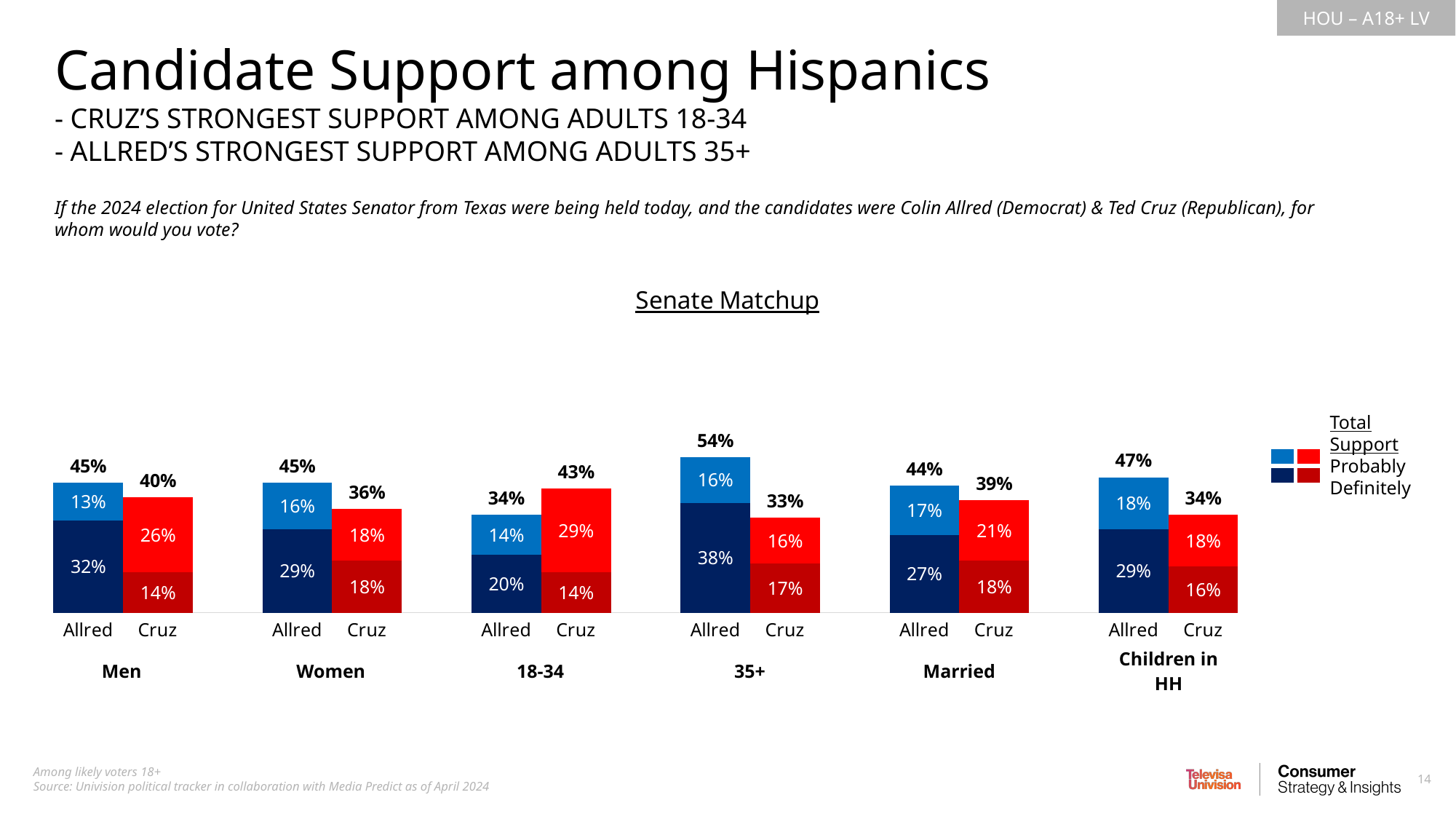
What is the 'Definitely' support for Cruz among adults 18-34? 14% Among adults 18-34, who has higher total support, Allred or Cruz? Cruz What type of chart is used on the slide? Stacked bar chart How many demographic groups are shown on the chart? 6 What two support levels does the legend distinguish? Probably and Definitely What is the 'Probably' support for Allred among adults 35+? 16% What is the sum of the 'Definitely' and 'Probably' segments for Cruz among Married voters? 39% What is the total support for Allred among Men? 45% Which demographic group shows the highest total support for Allred? 35+ What is the title of the chart? Senate Matchup What is the difference between Allred's and Cruz's total support among adults 35+? 21 percentage points Which demographic group shows the lowest total support for Cruz? 35+